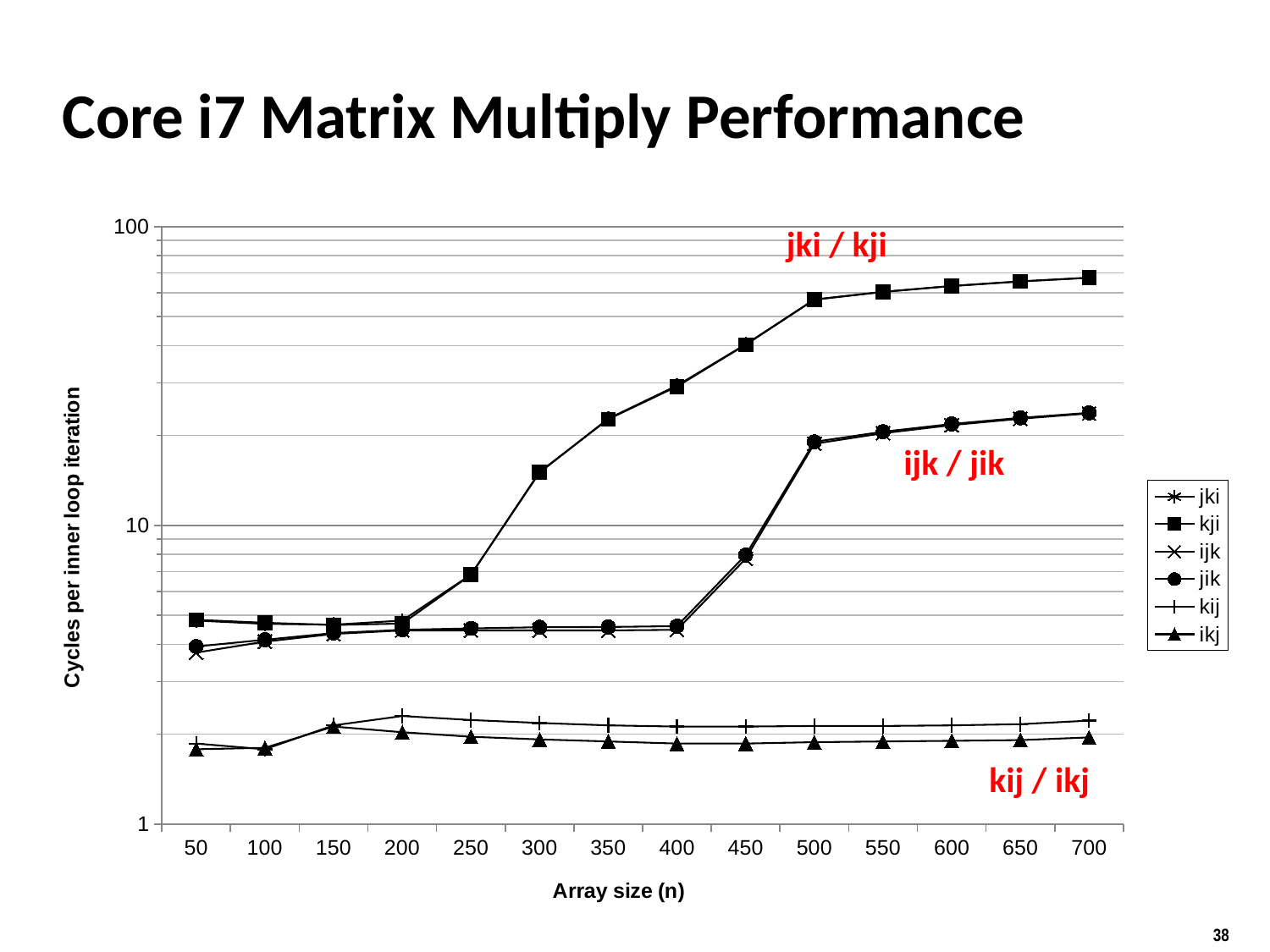
Which pair of series has the highest values at n=700? jki / kji Is the value for kji at n=200 greater or less than 10? less What is the label of the y axis? Cycles per inner loop iteration What is the title of the chart? Core i7 Matrix Multiply Performance Which pair of series has the lowest values at n=700? kij / ikj Is the value for kji at n=700 greater or less than 10? greater Do the values for kji rise or fall as the array size increases from 200 to 700? rise What kind of chart is shown on the slide? line chart Is the value for kij at n=700 greater or less than 10? less How many series does the legend list? 6 How many array sizes (n) are plotted along the x axis? 14